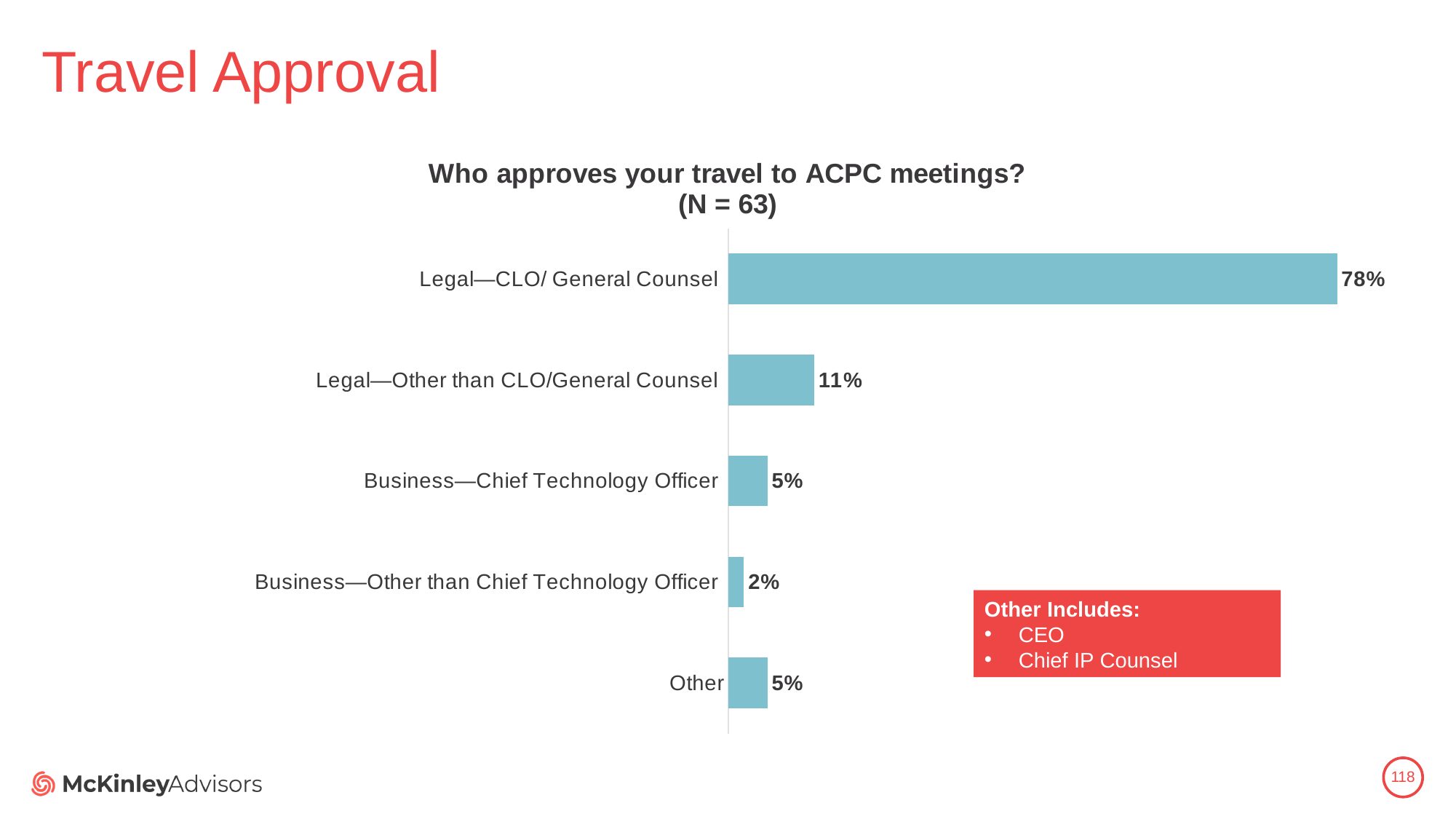
Which category has the lowest value? Business—Other than Chief Technology Officer What kind of chart is shown on the slide? Bar chart What is the title of the chart? Who approves your travel to ACPC meetings? (N = 63) Which category has the highest value? Legal—CLO/ General Counsel What is the value for Legal—Other than CLO/General Counsel? 11% How many categories are shown in the chart? 5 Which is larger: the value for Legal—Other than CLO/General Counsel or the value for Other? Legal—Other than CLO/General Counsel What is the value for Business—Chief Technology Officer? 5% What is the difference between the values for Legal—CLO/ General Counsel and Legal—Other than CLO/General Counsel? 67% What is the value for Business—Other than Chief Technology Officer? 2% What percentage of respondents said Legal—CLO/ General Counsel approves their travel to ACPC meetings? 78% According to the callout box, what does the Other category include? CEO and Chief IP Counsel